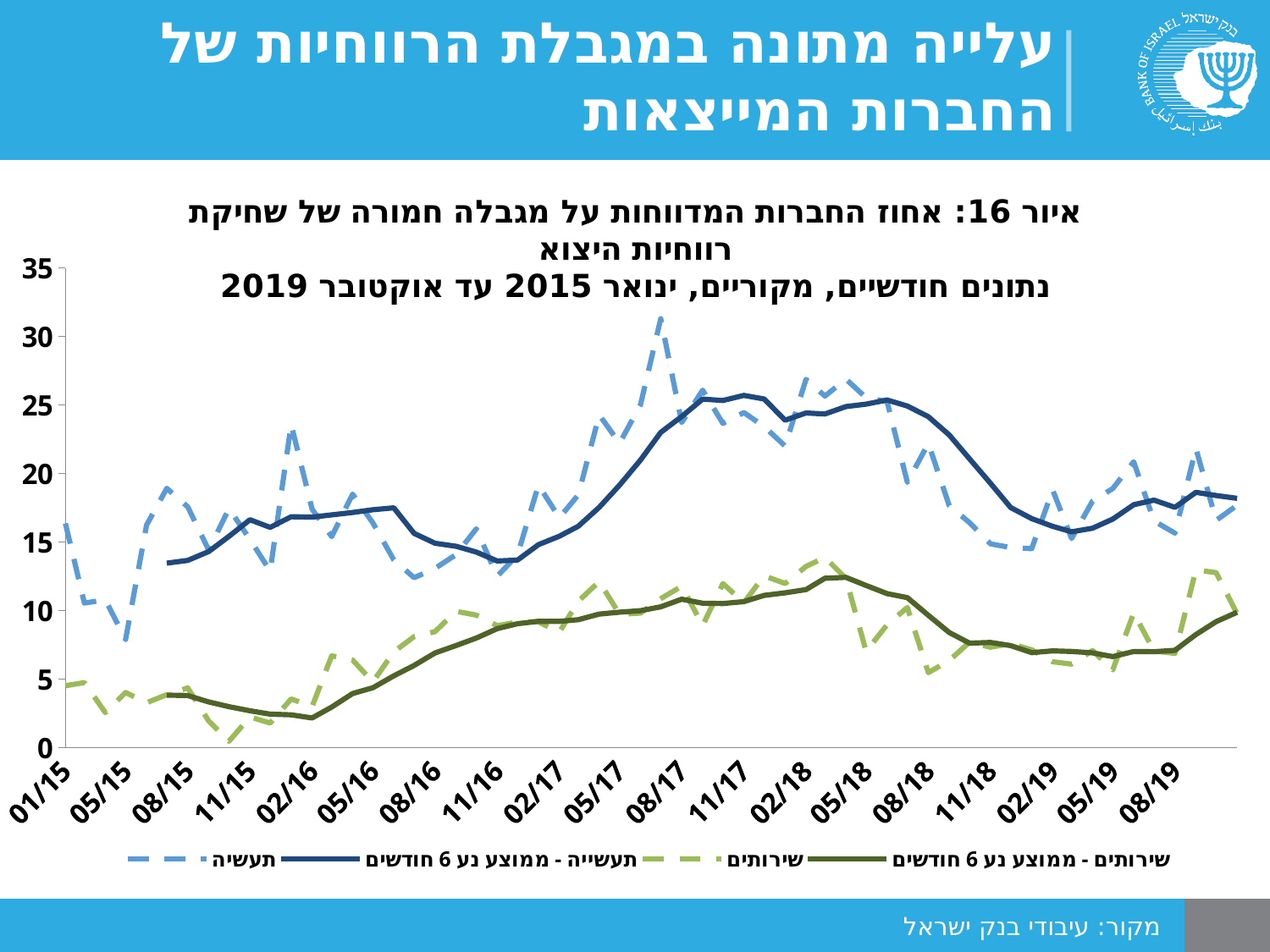
Does the תעשייה - ממוצע נע 6 חודשים series rise or fall between 05/18 and 02/19? fall Is the value of the שירותים - ממוצע נע 6 חודשים series at 02/16 greater or less than 5? less What is the highest value shown on the y axis? 35 At 08/17, which is larger: the תעשייה - ממוצע נע 6 חודשים series or the שירותים - ממוצע נע 6 חודשים series? תעשייה - ממוצע נע 6 חודשים Is the value of the תעשייה - ממוצע נע 6 חודשים series at 08/17 greater or less than 20? greater Is the value of the תעשייה - ממוצע נע 6 חודשים series at 11/18 greater or less than 20? less What kind of chart is shown on the slide? line chart Does the שירותים - ממוצע נע 6 חודשים series rise or fall between 02/16 and 05/18? rise How many date labels are shown on the x axis? 19 Which series reaches the highest value on the chart? תעשיה How many series does the legend list? 4